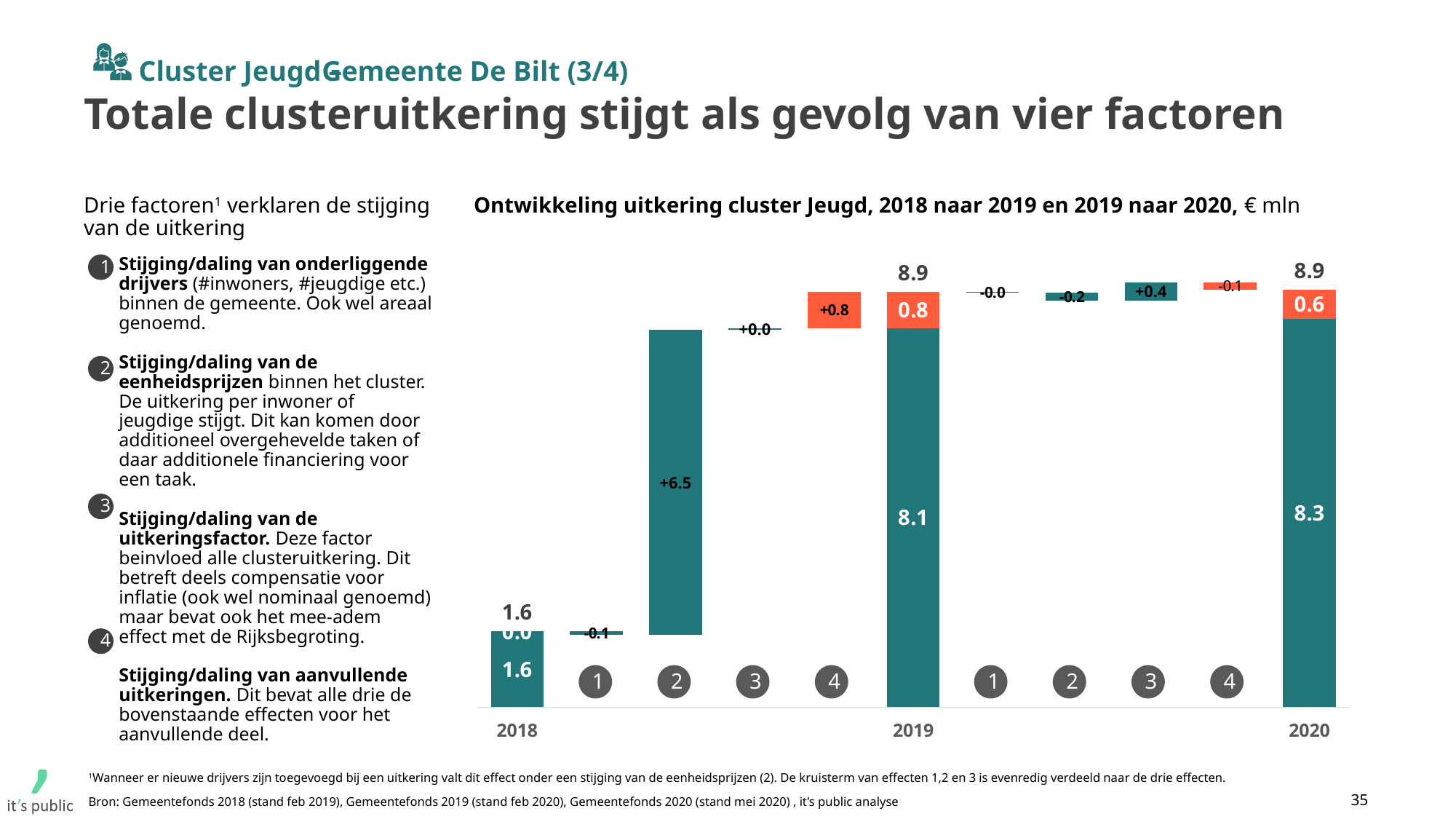
What is the value of the teal (lower) segment of the 2020 bar? 8.3 What is the value of step 2 between 2019 and 2020? -0.2 What is the value of step 3 between 2019 and 2020? +0.4 What is the value of step 2 between 2018 and 2019? +6.5 Which step has the largest change in the chart? Step 2 between 2018 and 2019 (+6.5) What is the value of the orange (upper) segment of the 2019 bar? 0.8 What kind of chart is shown on the slide? Bar chart (waterfall) What is the total value shown above the 2019 bar? 8.9 What is the difference between the 2019 total and the 2018 total? 7.3 What is the total value shown above the 2018 bar? 1.6 Which year has the larger total, 2018 or 2020? 2020 What is the value of step 4 between 2018 and 2019? +0.8